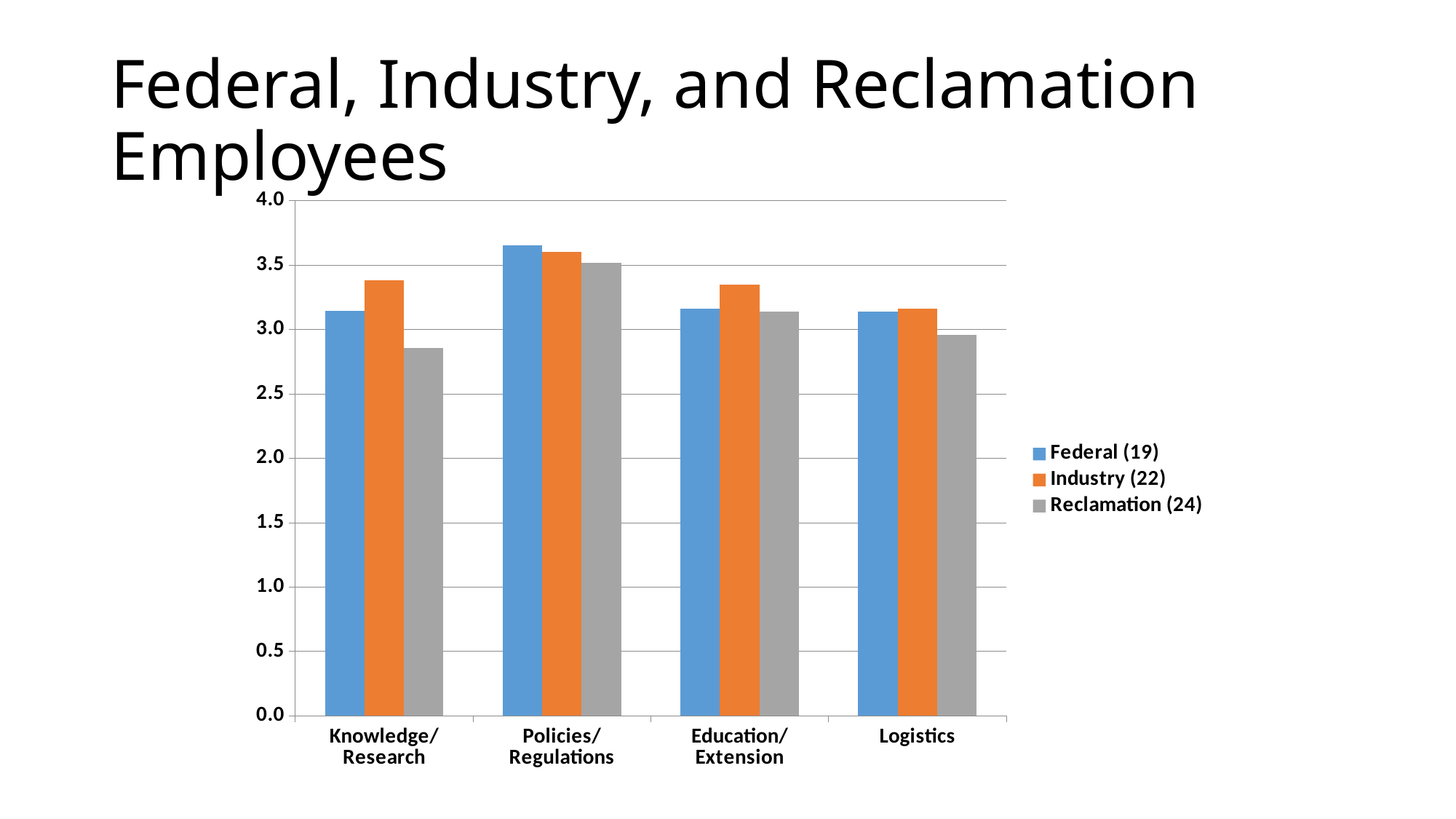
How many series does the legend list? 3 In the Knowledge/Research category, which is larger: the Industry (22) bar or the Reclamation (24) bar? Industry (22) Is the Reclamation (24) value for Knowledge/Research greater or less than 3.0? less For which category is the Industry (22) bar highest? Policies/Regulations How many categories are shown on the x axis? 4 For which category is the Reclamation (24) bar highest? Policies/Regulations Is the Industry (22) value for Education/Extension greater or less than 3.0? greater What is the title of the slide containing the chart? Federal, Industry, and Reclamation Employees What kind of chart is shown on the slide? bar chart Which series is shown in grey in the legend? Reclamation (24) Is the Federal (19) value for Policies/Regulations greater or less than 3.5? greater For which category is the Federal (19) bar highest? Policies/Regulations